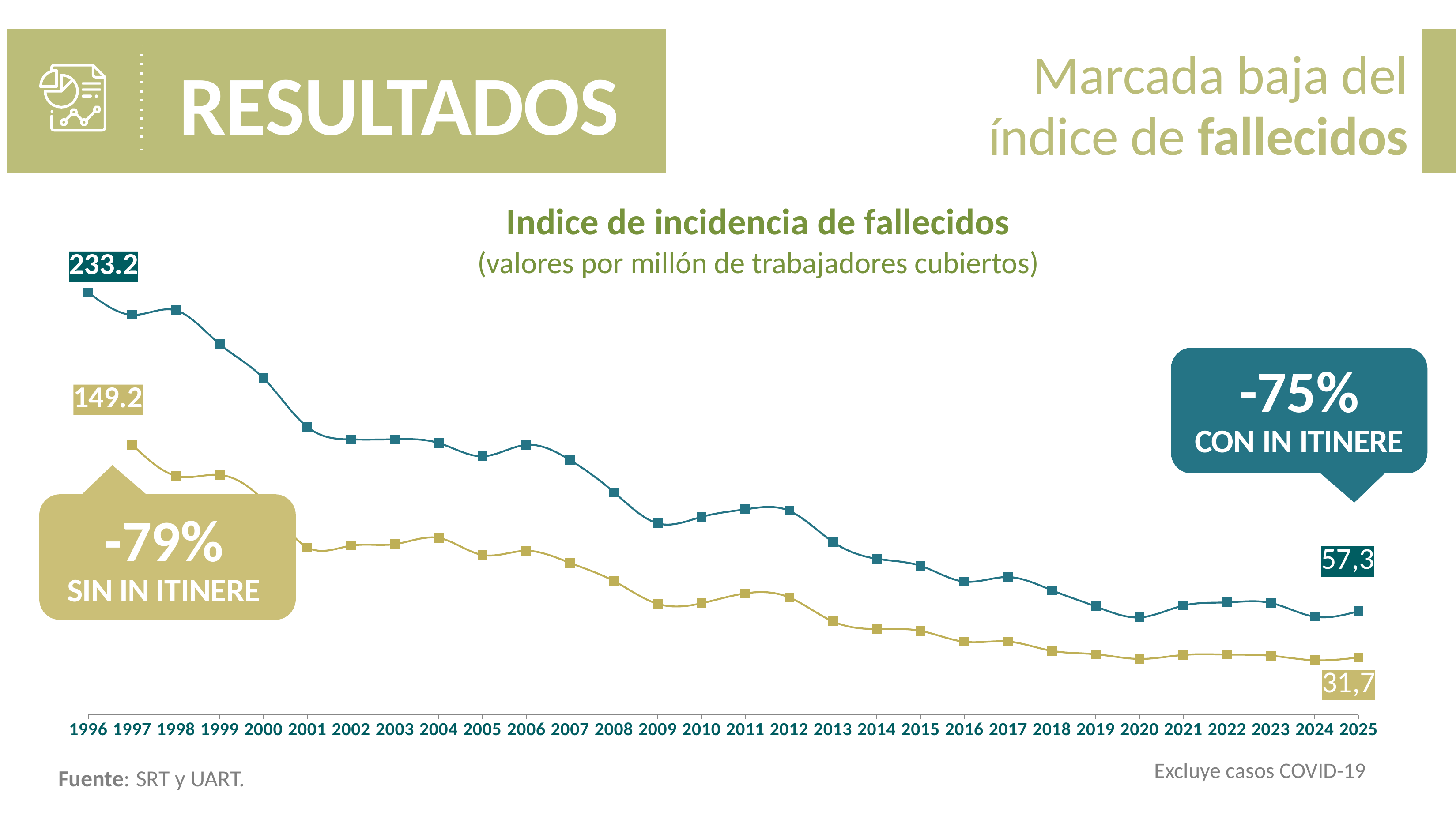
What is the title of the chart? Indice de incidencia de fallecidos How many series are plotted in the chart? 2 What percentage change is shown in the callout for the SIN IN ITINERE series? -79% What is the value of the CON IN ITINERE series in 1996? 233.2 Which series has the higher value in 2025, CON IN ITINERE or SIN IN ITINERE? CON IN ITINERE How many years are shown on the x axis of the chart? 30 What is the value of the SIN IN ITINERE series in 2025? 31,7 Do the values of the CON IN ITINERE series rise or fall from 1996 to 2025? fall What is the value of the CON IN ITINERE series in 2025? 57,3 What kind of chart is shown on the slide? line chart